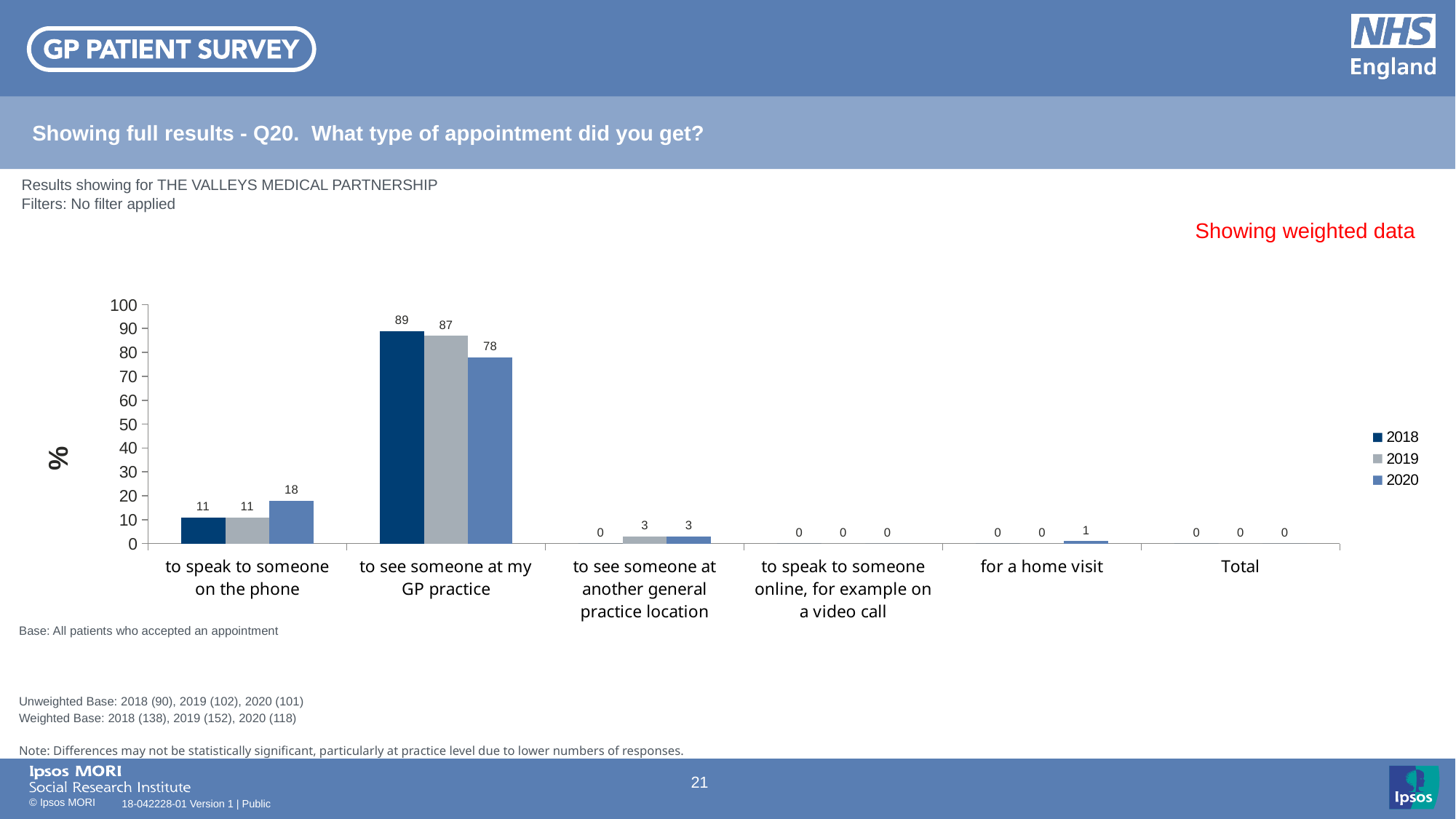
What is the difference between the 2018 and 2020 values for 'to see someone at my GP practice'? 11 How many series does the legend list? 3 Do the values for 'to see someone at my GP practice' rise or fall from 2018 to 2020? fall Which is larger: the 2019 value for 'to see someone at my GP practice' or the 2020 value for the same category? 2019 What kind of chart is shown on the slide? bar chart What is the 2020 value for 'for a home visit'? 1 What is the 2019 value for 'to see someone at another general practice location'? 3 What is the difference between the 2020 and 2019 values for 'to speak to someone on the phone'? 7 Which category has the highest value for 2018? to see someone at my GP practice What is the 2020 value for 'to see someone at my GP practice'? 78 How many categories are shown on the x axis? 7 What is the 2018 value for 'to speak to someone on the phone'? 11